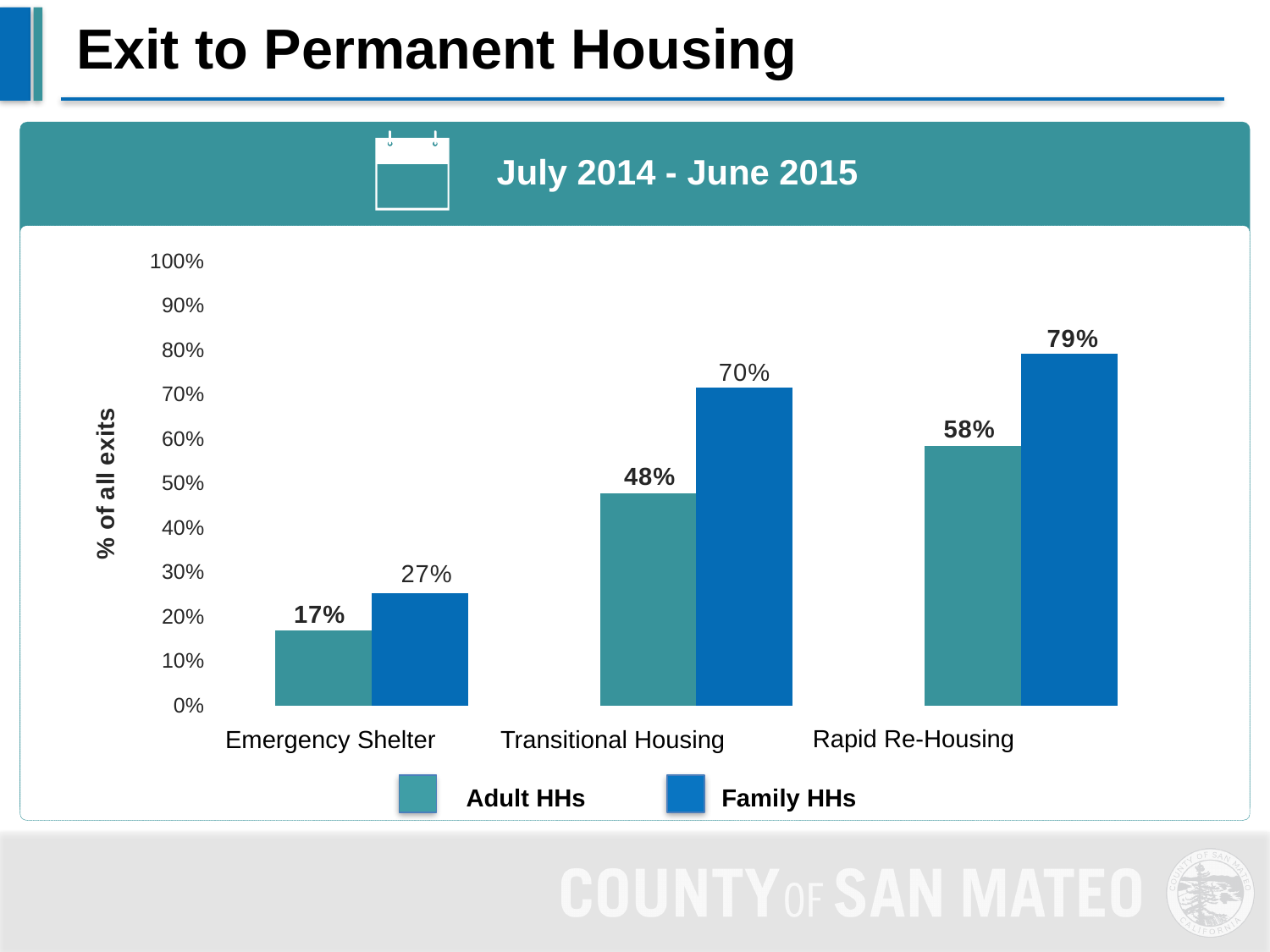
How many categories are shown on the x axis? 3 What is the difference between Family HHs and Adult HHs in Transitional Housing? 22% Which category has the highest value for Adult HHs? Rapid Re-Housing What is the value for Family HHs in Rapid Re-Housing? 79% What is the value for Family HHs in Transitional Housing? 70% How many series does the legend list? 2 Do the Adult HHs values rise or fall from Emergency Shelter to Rapid Re-Housing? Rise What time period does the chart cover? July 2014 - June 2015 Which category has the lowest value for Family HHs? Emergency Shelter What is the value for Adult HHs in Emergency Shelter? 17% Which is larger: Adult HHs in Rapid Re-Housing or Family HHs in Transitional Housing? Family HHs in Transitional Housing What kind of chart is shown? Bar chart